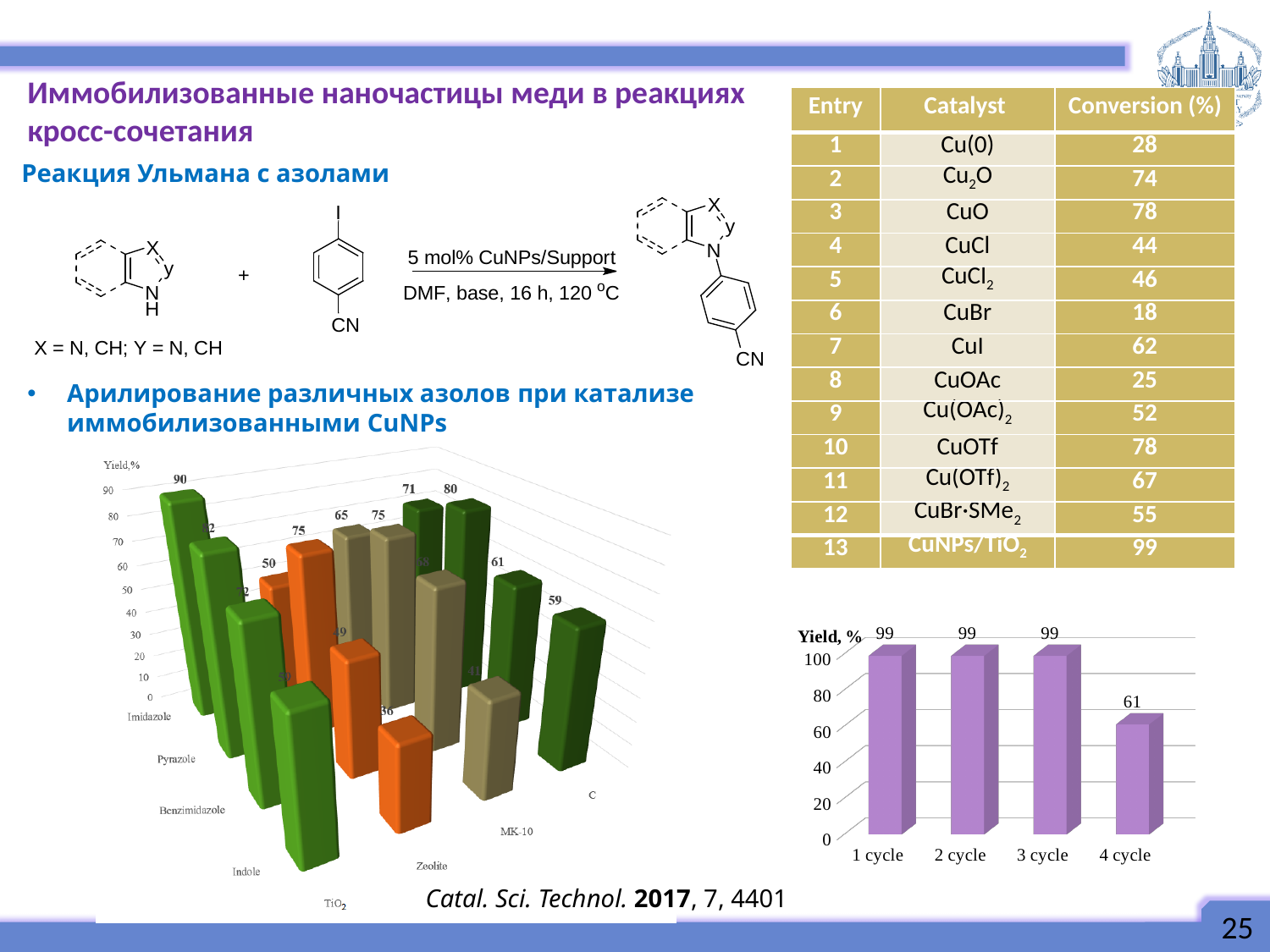
What kind of chart is the chart on the right showing yield by cycle? bar chart In the bar chart on the right (Yield, % by cycle), which is larger, the yield for 2 cycle or the yield for 4 cycle? 2 cycle In the bar chart on the right (Yield, % by cycle), which cycle has the lowest yield? 4 cycle In the bar chart on the right (Yield, % by cycle), what is the yield for 1 cycle? 99 What is the label of the vertical axis in the 3D bar chart on the left? Yield,% In the 3D bar chart on the left (Yield,%), what is the yield for Imidazole on TiO2? 90 How many cycles are shown in the bar chart on the right (Yield, % by cycle)? 4 In the bar chart on the right (Yield, % by cycle), what is the difference between the yield for 3 cycle and the yield for 4 cycle? 38 In the bar chart on the right (Yield, % by cycle), what is the yield for 4 cycle? 61 In the bar chart on the right (Yield, % by cycle), do the values rise or fall from 1 cycle to 4 cycle? fall In the 3D bar chart on the left (Yield,%), what is the highest yield value shown? 90 In the bar chart on the right (Yield, % by cycle), is the value for 4 cycle greater or less than 80? less